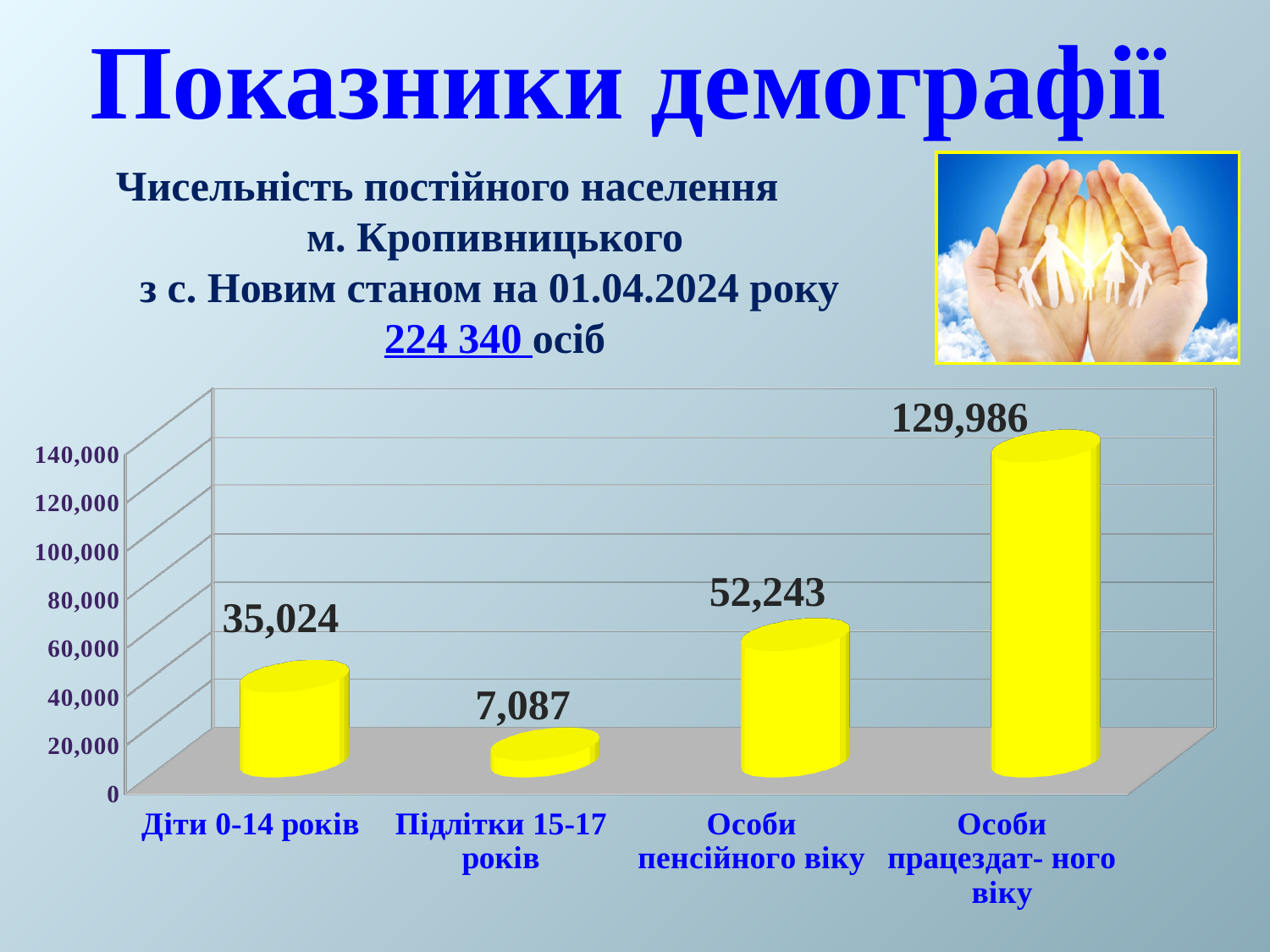
What is the value for Діти 0-14 років? 35,024 What is the difference between the values for Особи працездатного віку and Особи пенсійного віку? 77,743 What is the value for Особи працездатного віку? 129,986 Is the value for Особи пенсійного віку greater or less than 60,000? less What is the value for Особи пенсійного віку? 52,243 How many categories are shown in the chart? 4 What is the difference between the values for Діти 0-14 років and Підлітки 15-17 років? 27,937 What kind of chart is shown on the slide? bar chart Which is larger, the value for Діти 0-14 років or the value for Особи пенсійного віку? Особи пенсійного віку Which category has the highest value? Особи працездатного віку Which category has the lowest value? Підлітки 15-17 років What is the value for Підлітки 15-17 років? 7,087